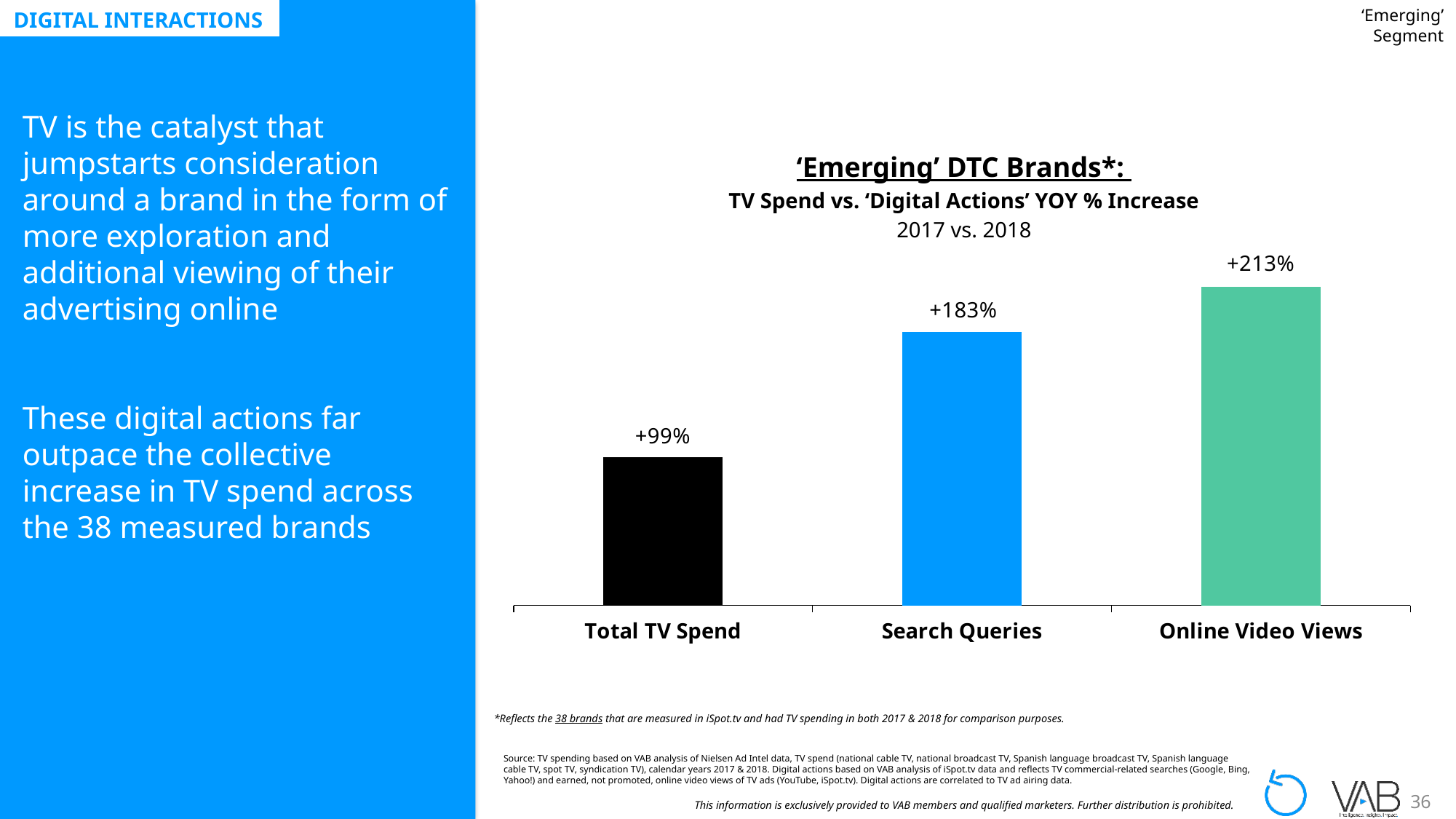
What is the difference in percentage points between the Search Queries increase and the Total TV Spend increase? 84 What is the difference in percentage points between the Online Video Views increase and the Total TV Spend increase? 114 What is the YOY % increase shown for Total TV Spend? +99% What is the YOY % increase shown for Search Queries? +183% How many categories are plotted in the chart? 3 What is the YOY % increase shown for Online Video Views? +213% Which two years does the chart compare? 2017 vs. 2018 What kind of chart is shown on the slide? Bar chart Which category has the lowest YOY % increase? Total TV Spend Which category has the highest YOY % increase? Online Video Views Which is larger, the increase for Search Queries or the increase for Online Video Views? Online Video Views Do the values rise or fall moving from left to right across the categories? Rise